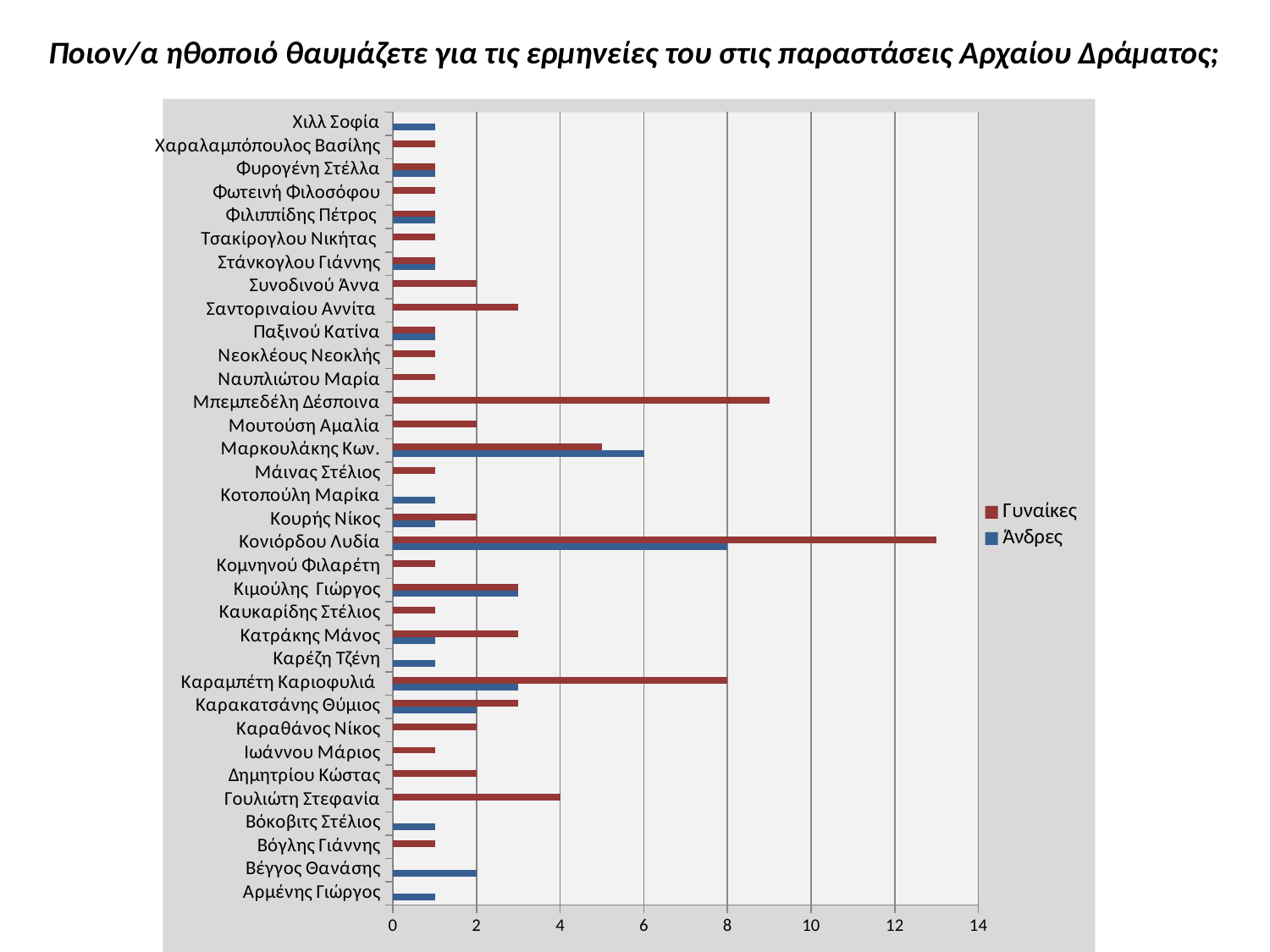
What is the difference between the Άνδρες values for Κονιόρδου Λυδία and Μαρκουλάκης Κων.? 2 What is the Άνδρες value for Μαρκουλάκης Κων.? 6 Which actor has the highest value for Άνδρες? Κονιόρδου Λυδία What is the Γυναίκες value for Γουλιώτη Στεφανία? 4 What kind of chart is shown on the slide? bar chart How many actors (categories) are listed on the chart? 34 How many series does the legend list? 2 Which actor has the highest value for Γυναίκες? Κονιόρδου Λυδία What are the two series named in the legend? Γυναίκες and Άνδρες What is the Άνδρες value for Κονιόρδου Λυδία? 8 For Καραμπέτη Καριοφυλιά, which series has the larger value, Γυναίκες or Άνδρες? Γυναίκες Is the Γυναίκες value for Κονιόρδου Λυδία greater or less than 12? greater